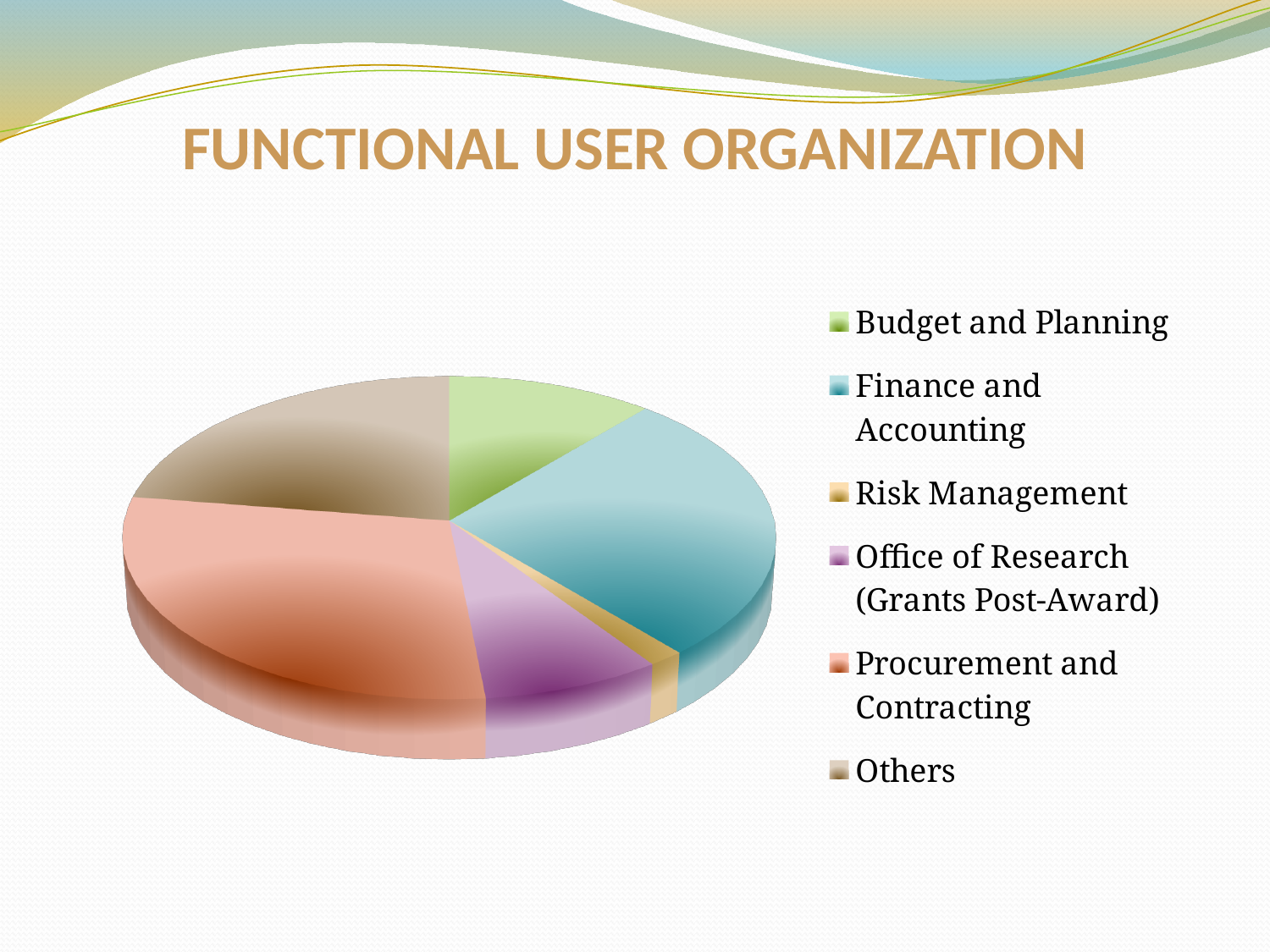
Which category has the smallest slice of the pie chart? Risk Management What is the title of the slide containing the pie chart? FUNCTIONAL USER ORGANIZATION Which slice is larger, Budget and Planning or Risk Management? Budget and Planning Which slice is larger, Finance and Accounting or Budget and Planning? Finance and Accounting Which slice is larger, Finance and Accounting or Office of Research (Grants Post-Award)? Finance and Accounting How many categories does the pie chart show? 6 What kind of chart is shown on the slide? Pie chart Which category has the largest slice of the pie chart? Procurement and Contracting What colour is the Procurement and Contracting slice in the pie chart? Orange